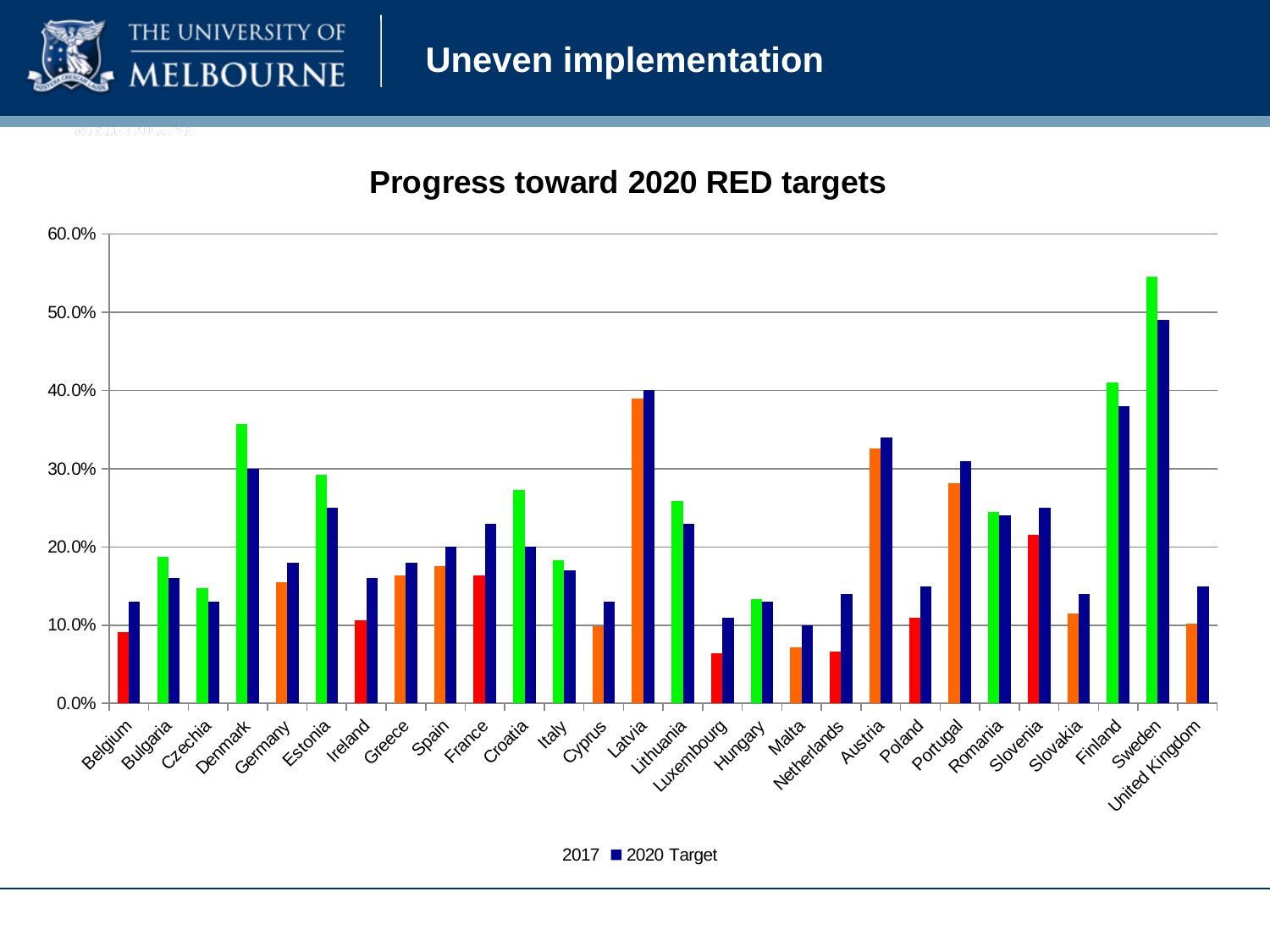
For Denmark, which is larger: the 2017 value or the 2020 Target value? 2017 Which country has the highest 2017 value? Sweden Which country has the highest 2020 Target value? Sweden How many countries are shown on the x axis? 28 What is the title of the chart? Progress toward 2020 RED targets For the Netherlands, which is larger: the 2017 value or the 2020 Target value? 2020 Target What type of chart is shown on the slide? Bar chart Is the 2017 value for Belgium greater or less than 10.0%? less Is the 2017 value for Denmark greater or less than 30.0%? greater Is the 2017 value for Sweden greater or less than 50.0%? greater How many series does the legend list? 2